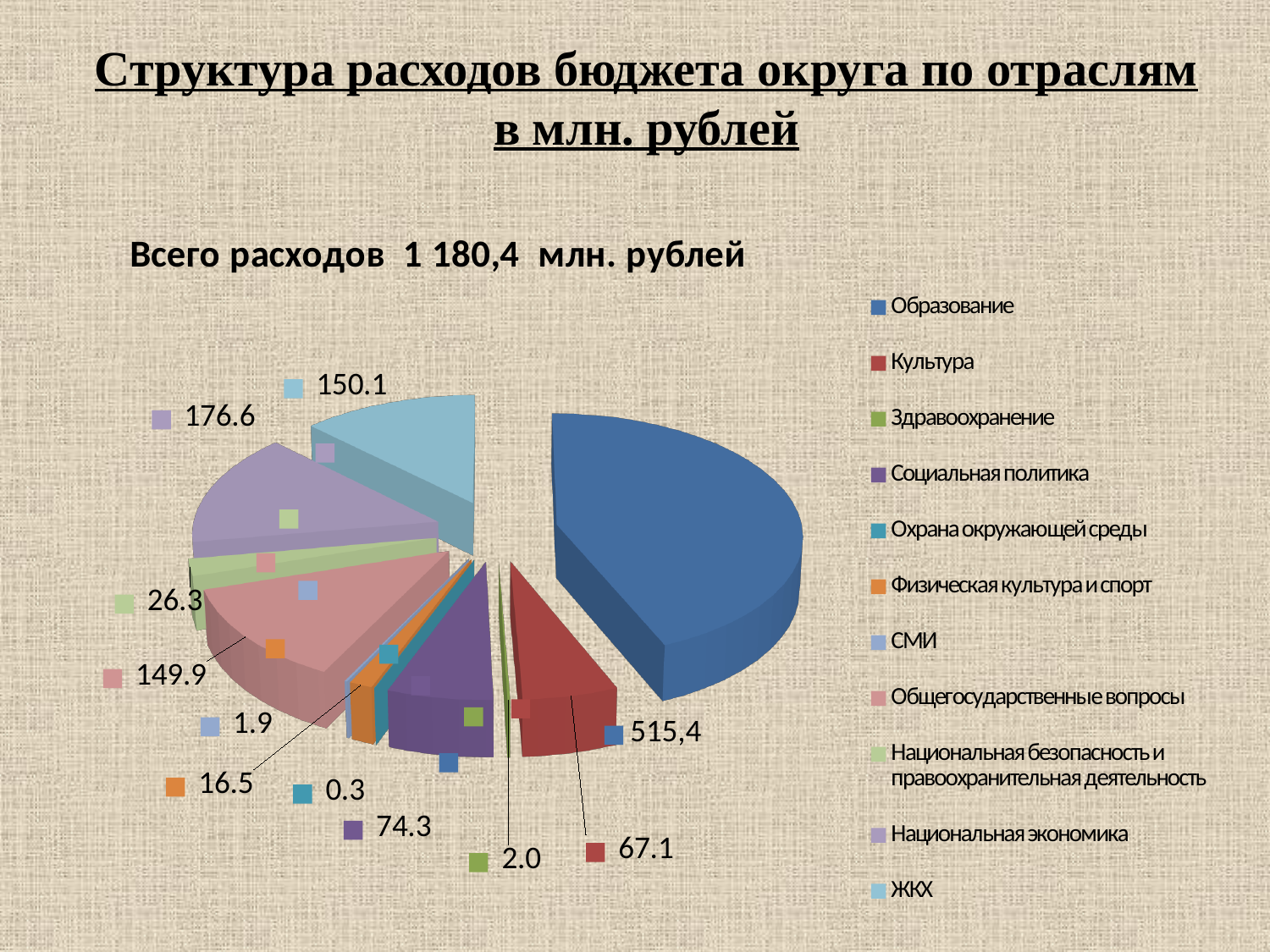
What is the difference between the values for Национальная экономика and ЖКХ? 26.5 Which category has the largest share of the pie? Образование What kind of chart is shown on the slide? Pie chart What total expenditure is stated on the slide? 1 180,4 млн. рублей What is the value for Физическая культура и спорт? 16.5 What is the value for Образование? 515,4 How many categories does the pie chart have? 11 What is the value for Национальная экономика? 176.6 What is the title of the slide? Структура расходов бюджета округа по отраслям в млн. рублей Which category has the smallest value? Охрана окружающей среды Which is larger, Национальная экономика or ЖКХ? Национальная экономика What is the value for Социальная политика? 74.3